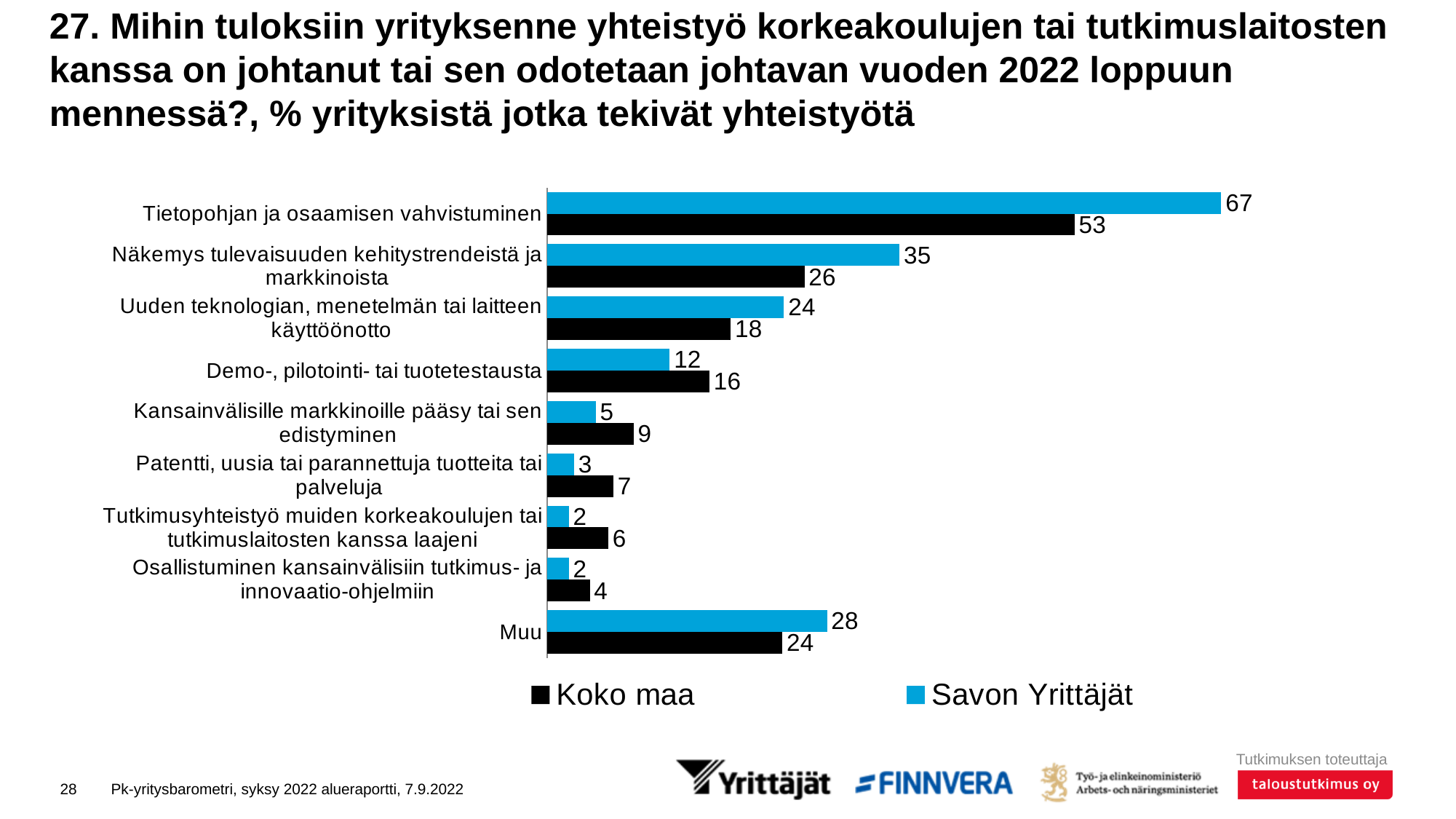
Which category has the highest value for Koko maa? Tietopohjan ja osaamisen vahvistuminen How many series does the legend list? 2 How many categories are shown on the chart? 9 For "Uuden teknologian, menetelmän tai laitteen käyttöönotto", which series has the larger value, Koko maa or Savon Yrittäjät? Savon Yrittäjät What is the value for Koko maa for "Muu"? 24 For "Demo-, pilotointi- tai tuotetestausta", which series has the larger value, Koko maa or Savon Yrittäjät? Koko maa What is the difference between the Savon Yrittäjät and Koko maa values for "Näkemys tulevaisuuden kehitystrendeistä ja markkinoista"? 9 Which colour represents Savon Yrittäjät in the chart? Blue What is the value for Savon Yrittäjät for "Tietopohjan ja osaamisen vahvistuminen"? 67 What is the value for Koko maa for "Demo-, pilotointi- tai tuotetestausta"? 16 What kind of chart is shown on the slide? Bar chart Which category has the lowest value for Koko maa? Osallistuminen kansainvälisiin tutkimus- ja innovaatio-ohjelmiin